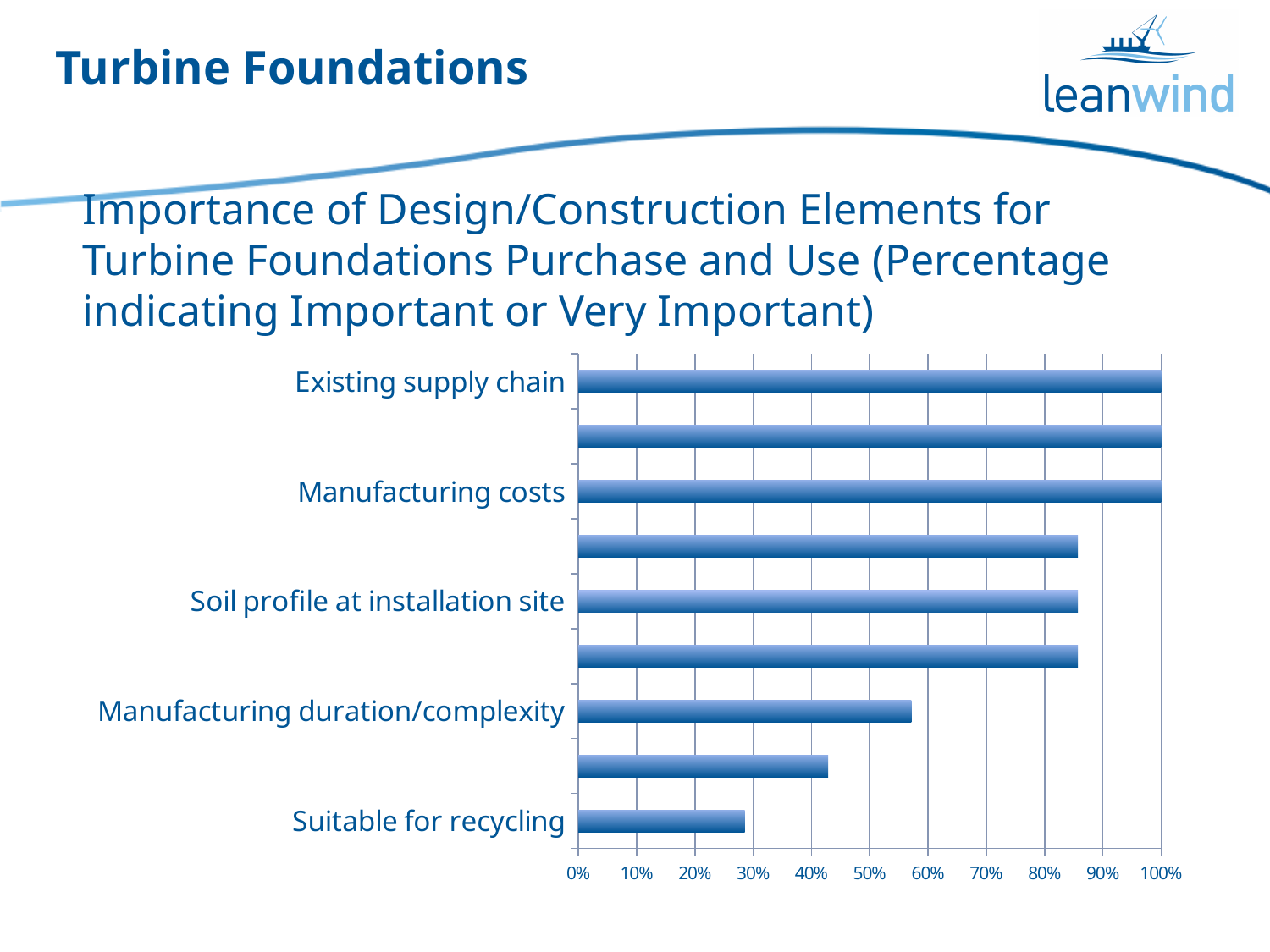
How many bars are plotted in the chart? 9 Is the value for Manufacturing duration/complexity greater or less than 60%? less Which is larger, the value for Manufacturing costs or the value for Suitable for recycling? Manufacturing costs What is the value for Existing supply chain? 100% Which is larger, the value for Soil profile at installation site or the value for Manufacturing duration/complexity? Soil profile at installation site What kind of chart is shown on the slide? bar chart Is the value for Manufacturing duration/complexity greater or less than 50%? greater Is the value for Soil profile at installation site greater or less than 80%? greater Which labelled category has the lowest value in the chart? Suitable for recycling What is the highest value shown on the horizontal axis of the chart? 100%